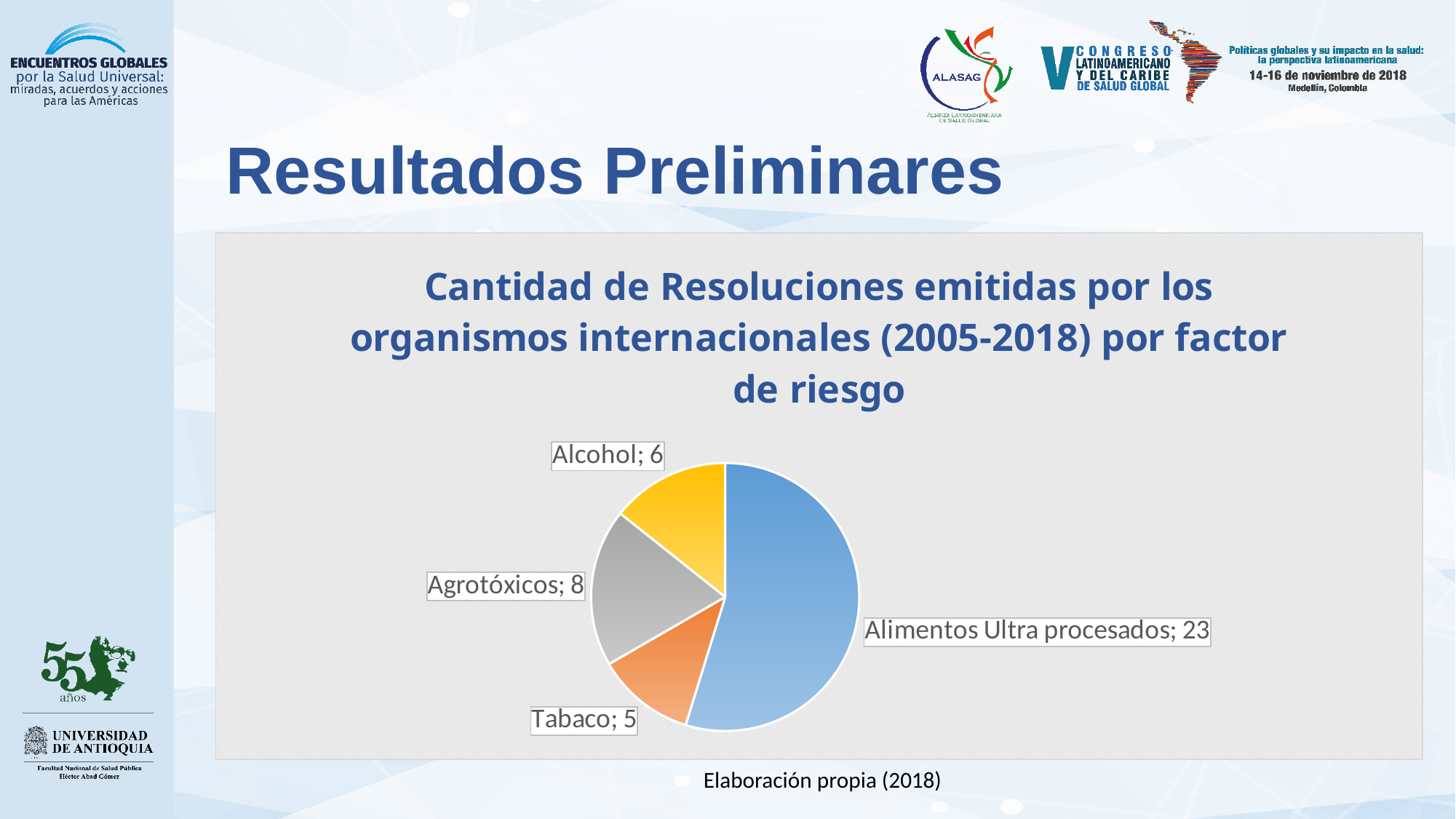
How many resolutions were issued for Alcohol? 6 What is the difference between the number of resolutions for Alimentos Ultra procesados and Agrotóxicos? 15 What type of chart is shown on the slide? pie chart How many resolutions were issued for Alimentos Ultra procesados? 23 What is the total number of resolutions across all risk factors in the pie chart? 42 How many resolutions were issued for Agrotóxicos? 8 Which has more resolutions, Alcohol or Agrotóxicos? Agrotóxicos How many risk factor categories are shown in the pie chart? 4 How many resolutions were issued for Tabaco? 5 Which risk factor has the lowest number of resolutions? Tabaco Which risk factor has the highest number of resolutions? Alimentos Ultra procesados What is the title of the pie chart? Cantidad de Resoluciones emitidas por los organismos internacionales (2005-2018) por factor de riesgo